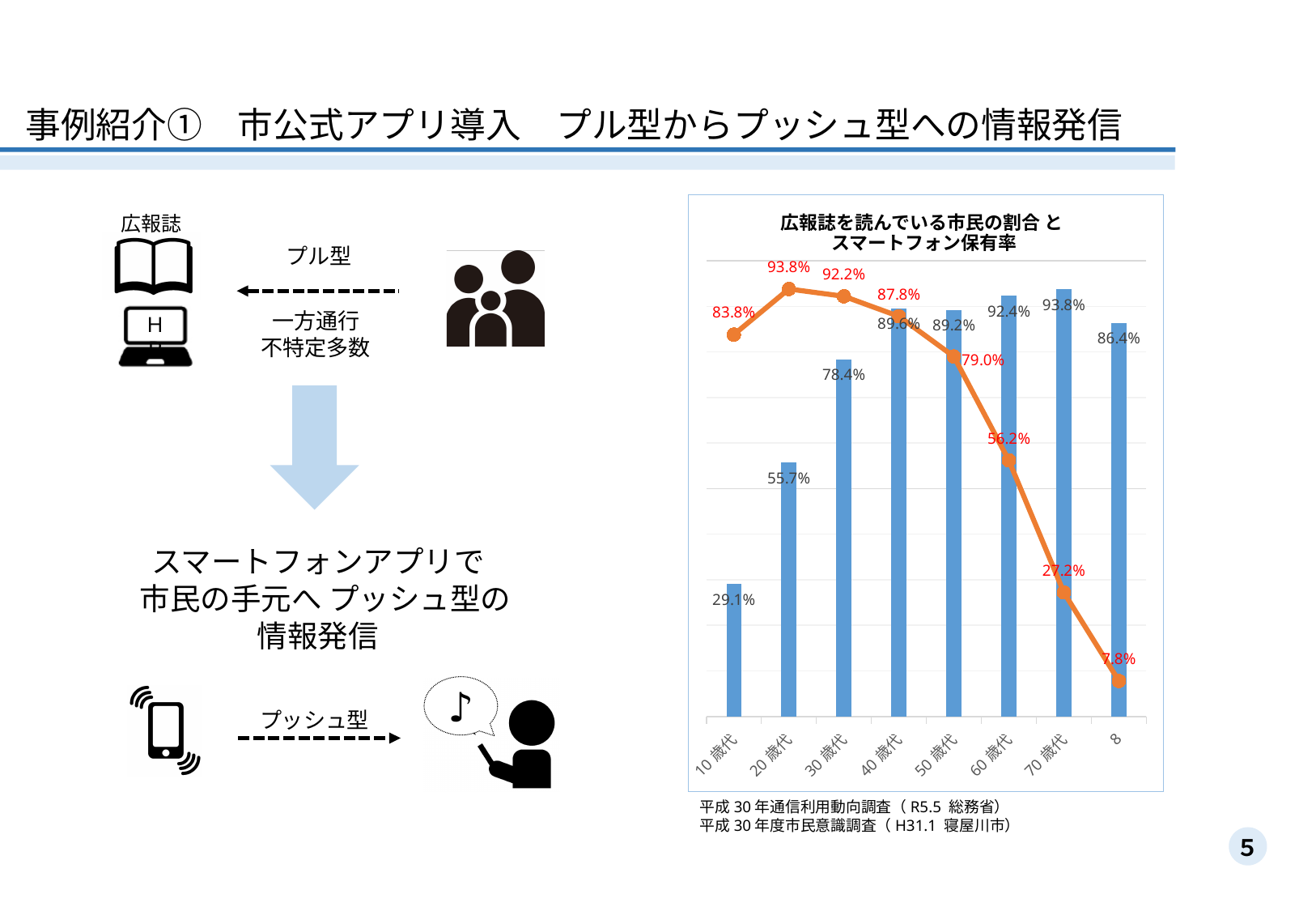
In the chart, what value does the orange line show for 50歳代? 79.0% How many age-group categories are plotted along the x axis of the chart? 8 At 70歳代, how much higher is the blue bar value than the orange line value? 66.6 percentage points What is the difference between the blue bar values for 20歳代 and 10歳代? 26.6 percentage points In the chart, what is the value of the blue bar for 30歳代? 78.4% Which age group has the highest blue bar in the chart? 70歳代 In the chart, what is the value of the blue bar for 10歳代? 29.1% What kind of chart is shown on the right of the slide? A bar chart combined with a line chart At 60歳代, which is larger: the blue bar or the orange line value? The blue bar (92.4%) From 20歳代 onward, does the orange line rise or fall as age increases? It falls At which age group does the orange line reach its highest value? 20歳代 Which age group has the lowest blue bar in the chart? 10歳代